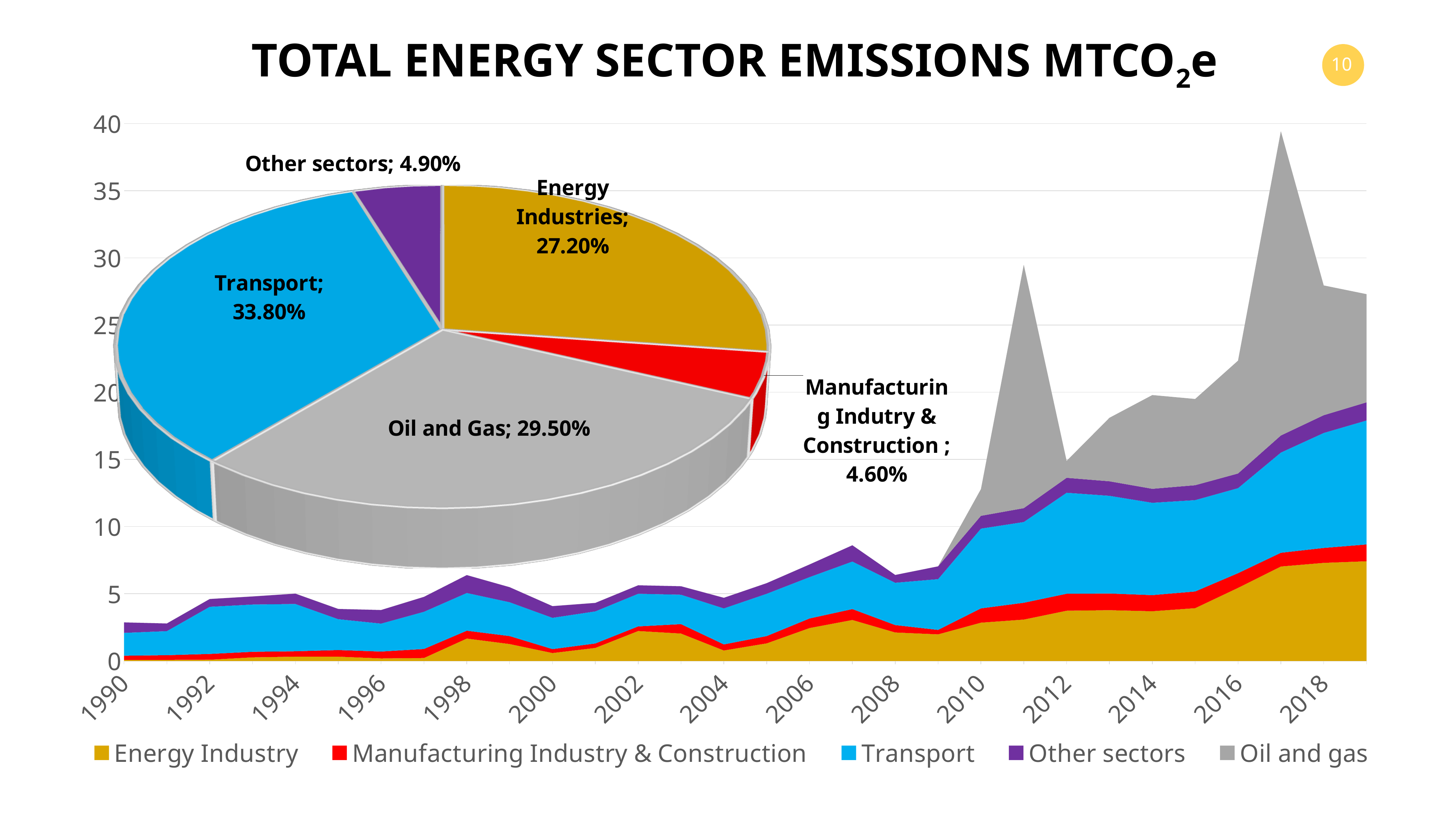
In the area chart, do total emissions generally rise or fall from 1990 to 2019? rise In the area chart, which colour represents Oil and gas? Grey How many slices does the pie chart have? 5 In the area chart, is the total emissions value for 2017 greater or less than 35? greater What kind of chart is the large chart with years along the x axis? Stacked area chart In the pie chart, which sector has the largest share? Transport How many series does the legend of the area chart list? 5 In the pie chart, which sector has the smallest share? Manufacturing Industry & Construction In the pie chart, which is larger: the Oil and Gas share or the Energy Industries share? Oil and Gas In the pie chart, what share does Other sectors have? 4.90% In the pie chart, what is the difference between the Oil and Gas share and the Energy Industries share? 2.30% In the pie chart, what share does Transport have? 33.80%